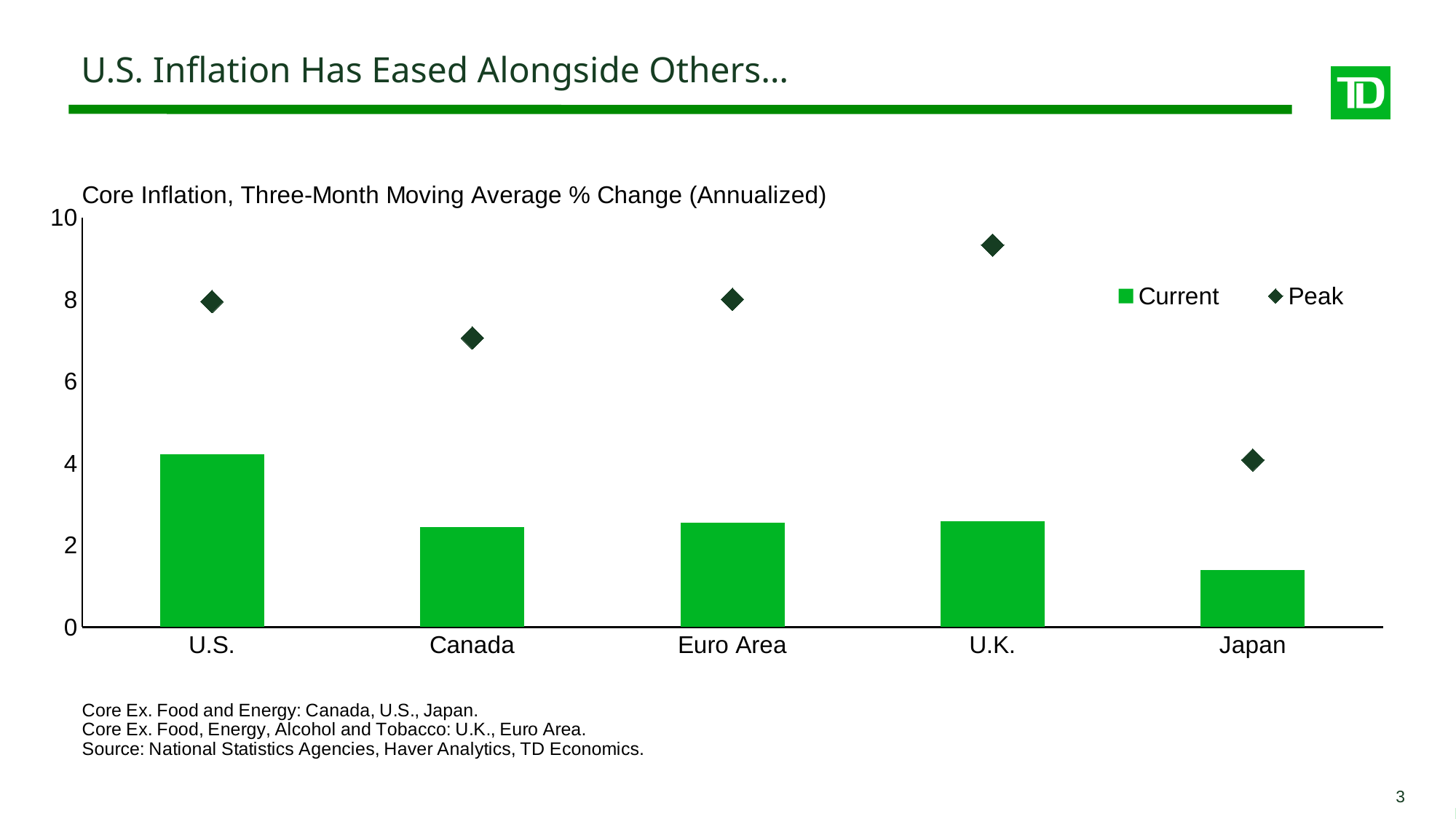
What kind of chart is shown on the slide? bar chart Is the Peak value for Canada greater or less than 8? less How many countries or regions are shown on the x axis? 5 Is the Current value for Japan greater or less than 2? less How many series does the legend list? 2 Which country or region has the highest Current core inflation value? U.S. What is the title of the chart? Core Inflation, Three-Month Moving Average % Change (Annualized) Which country or region has the lowest Current core inflation value? Japan Is the Peak value for the U.K. greater or less than 8? greater Which is larger, the Current value for the U.S. or the Current value for Canada? U.S. Which country or region has the lowest Peak core inflation value? Japan Which country or region has the highest Peak core inflation value? U.K.